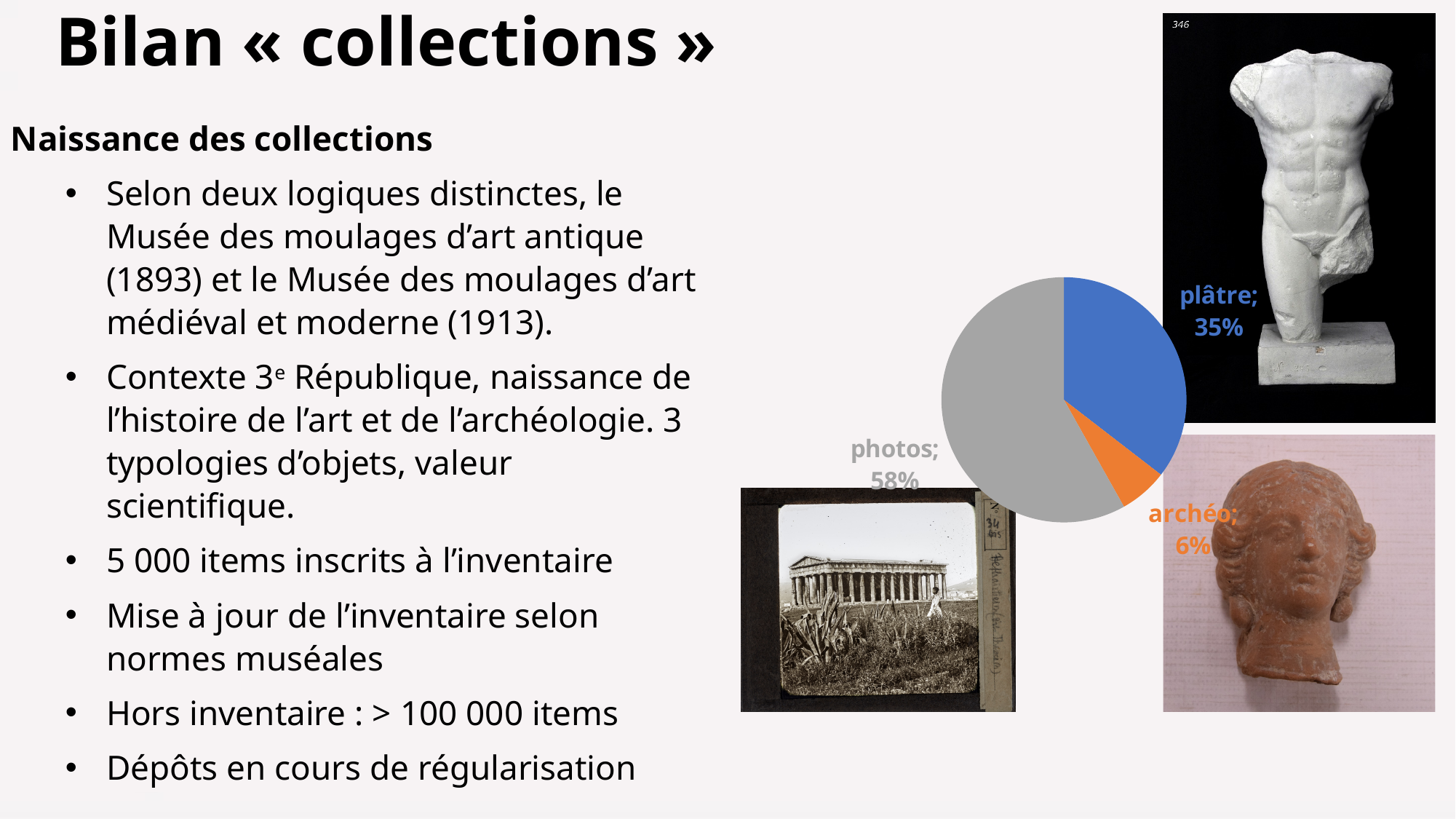
Which slice is larger, 'plâtre' or 'archéo'? plâtre What colour is the 'photos' slice of the pie chart? grey What share of the pie chart is labelled 'photos'? 58% What share of the pie chart is labelled 'plâtre'? 35% Which category has the largest slice in the pie chart? photos What is the difference in percentage points between the 'plâtre' slice and the 'archéo' slice? 29 Which category has the smallest slice in the pie chart? archéo What share of the pie chart is labelled 'archéo'? 6% How many slices does the pie chart have? 3 What kind of chart is shown on the slide? pie chart What colour is the 'archéo' slice of the pie chart? orange What is the difference in percentage points between the 'photos' slice and the 'plâtre' slice? 23